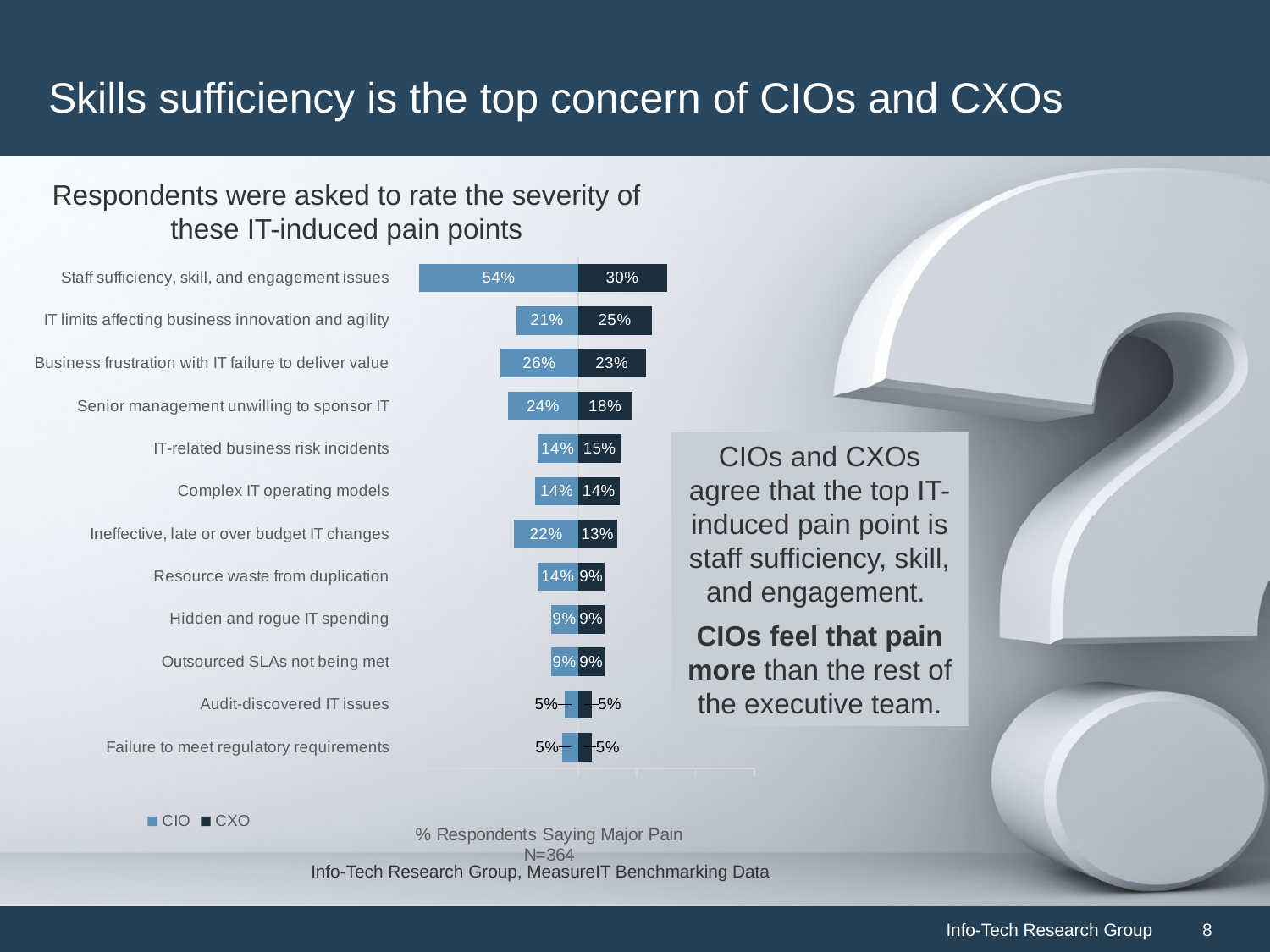
What percentage of CXO respondents said 'IT limits affecting business innovation and agility' was a major pain? 25% What is the difference between the CIO and CXO values for 'Staff sufficiency, skill, and engagement issues'? 24 percentage points Which pain point has the highest CXO percentage? Staff sufficiency, skill, and engagement issues What is the CIO value for 'Ineffective, late or over budget IT changes'? 22% How many pain points are listed in the chart? 12 How many series does the chart legend list? 2 What is the difference between the CIO and CXO values for 'Senior management unwilling to sponsor IT'? 6 percentage points What percentage of CIO respondents said 'Staff sufficiency, skill, and engagement issues' was a major pain? 54% For 'Business frustration with IT failure to deliver value', which group has the larger value, CIO or CXO? CIO For 'IT limits affecting business innovation and agility', which group has the larger value, CIO or CXO? CXO What type of chart is shown on the slide? Bar chart Which pain point has the highest CIO percentage? Staff sufficiency, skill, and engagement issues